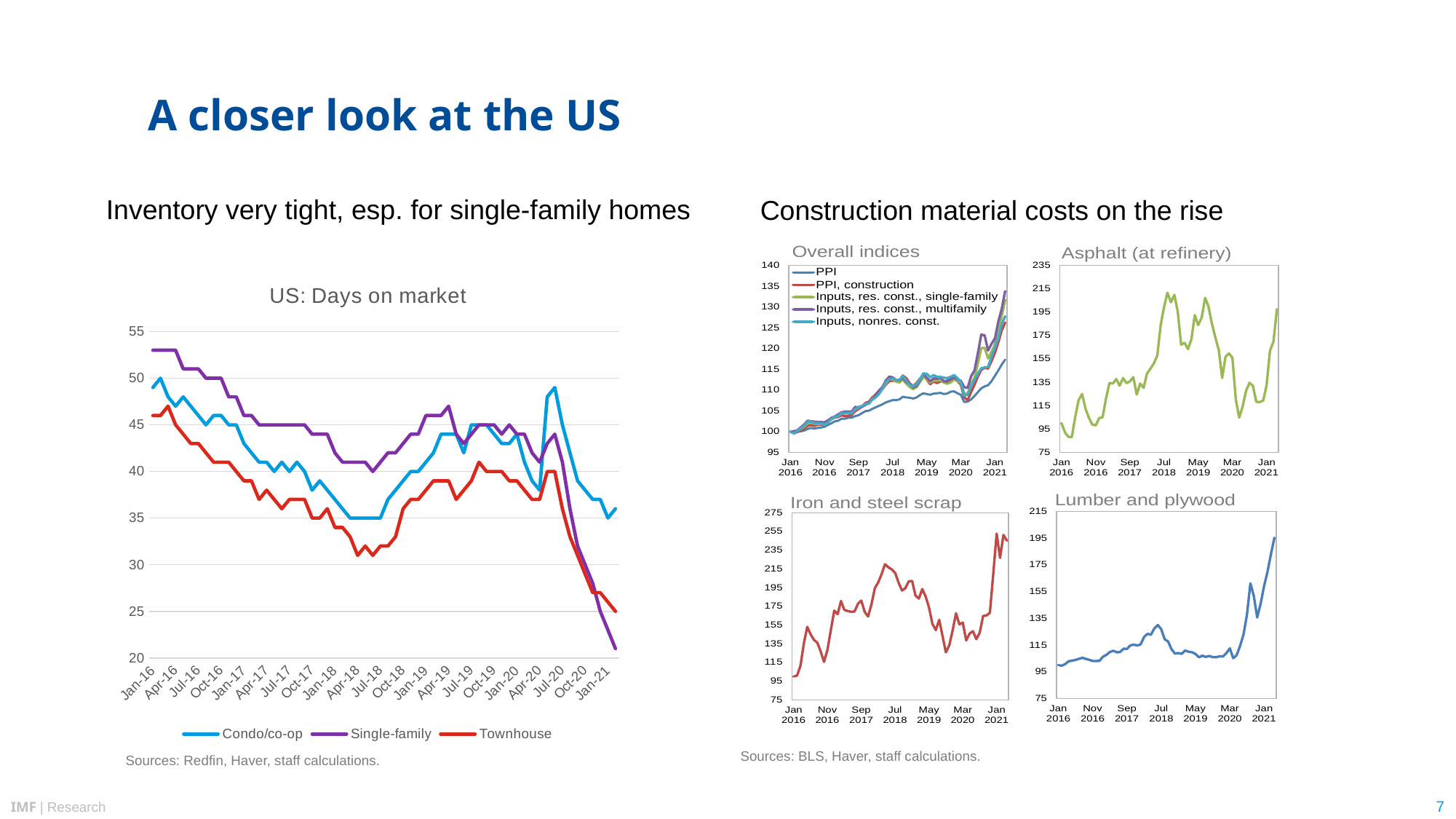
How many series does the legend of the "US: Days on market" chart list? 3 In the "US: Days on market" chart, which series is drawn in red? Townhouse In the "US: Days on market" chart, is the Townhouse value at Jan-21 greater or less than 30? less In the "US: Days on market" chart, is the Single-family value at Jan-16 greater or less than 50? greater In the "US: Days on market" chart, which series has the lowest value at Jan-21? Single-family How many series does the legend of the "Overall indices" chart list? 5 In the "Asphalt (at refinery)" chart, is the value at Jan 2016 greater or less than 115? less In the "US: Days on market" chart, which series is higher at Jan-16, Single-family or Townhouse? Single-family In the "Overall indices" chart, does the PPI series rise or fall from Jan 2016 to Jan 2021? rise In the "Lumber and plywood" chart, do values rise or fall between Mar 2020 and Jan 2021? rise What kind of chart is the "US: Days on market" chart? Line chart